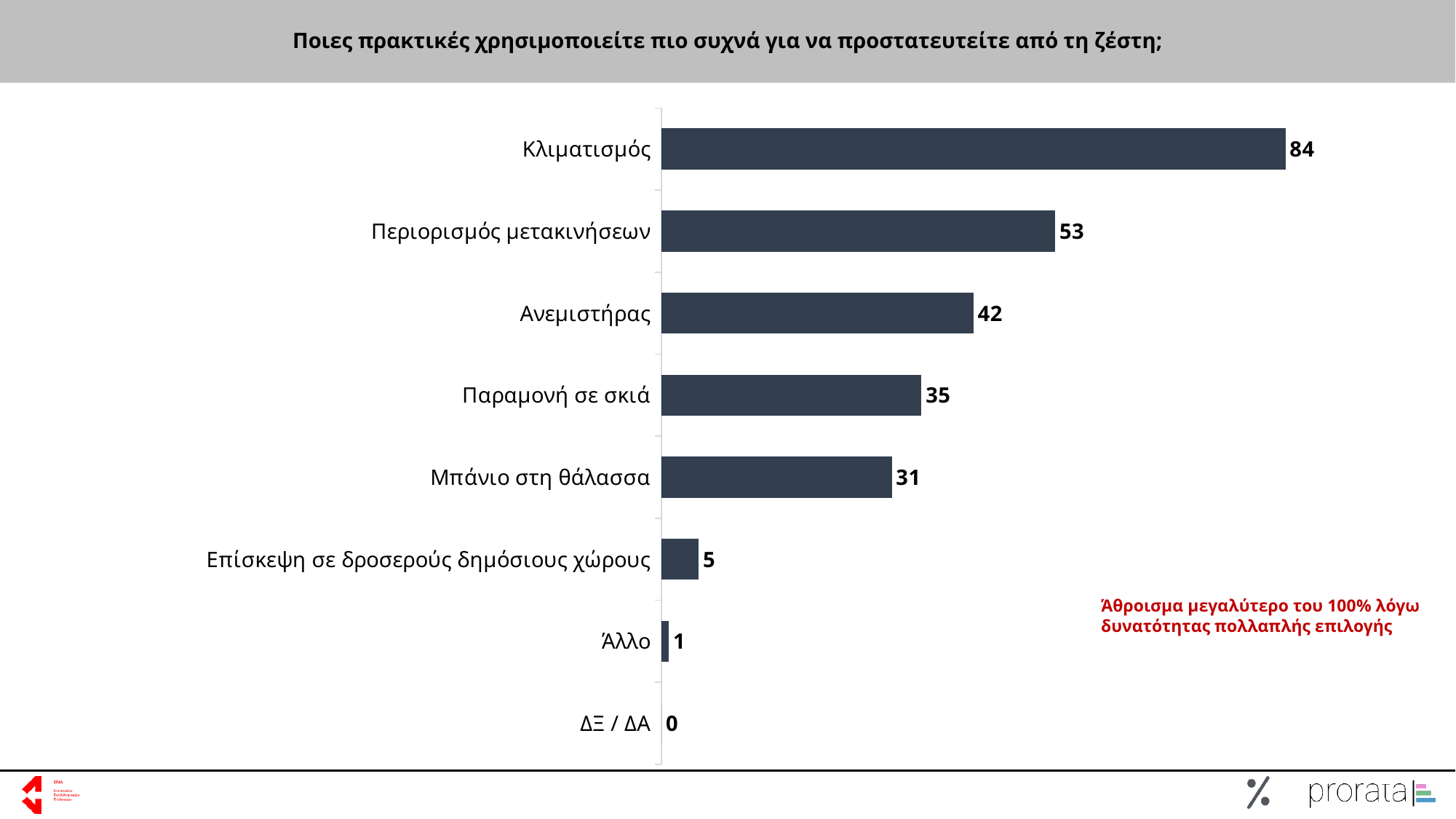
What kind of chart is shown on the slide? Bar chart What is the value for Περιορισμός μετακινήσεων? 53 What is the value for Επίσκεψη σε δροσερούς δημόσιους χώρους? 5 What is the value for Κλιματισμός? 84 Which category has the lowest value? ΔΞ / ΔΑ What is the difference between the values for Κλιματισμός and Περιορισμός μετακινήσεων? 31 What is the title of the chart? Ποιες πρακτικές χρησιμοποιείτε πιο συχνά για να προστατευτείτε από τη ζέστη; What is the value for Μπάνιο στη θάλασσα? 31 What is the difference between the values for Ανεμιστήρας and Παραμονή σε σκιά? 7 Which is larger, the value for Ανεμιστήρας or the value for Μπάνιο στη θάλασσα? Ανεμιστήρας Which category has the highest value? Κλιματισμός How many categories are shown in the chart? 8